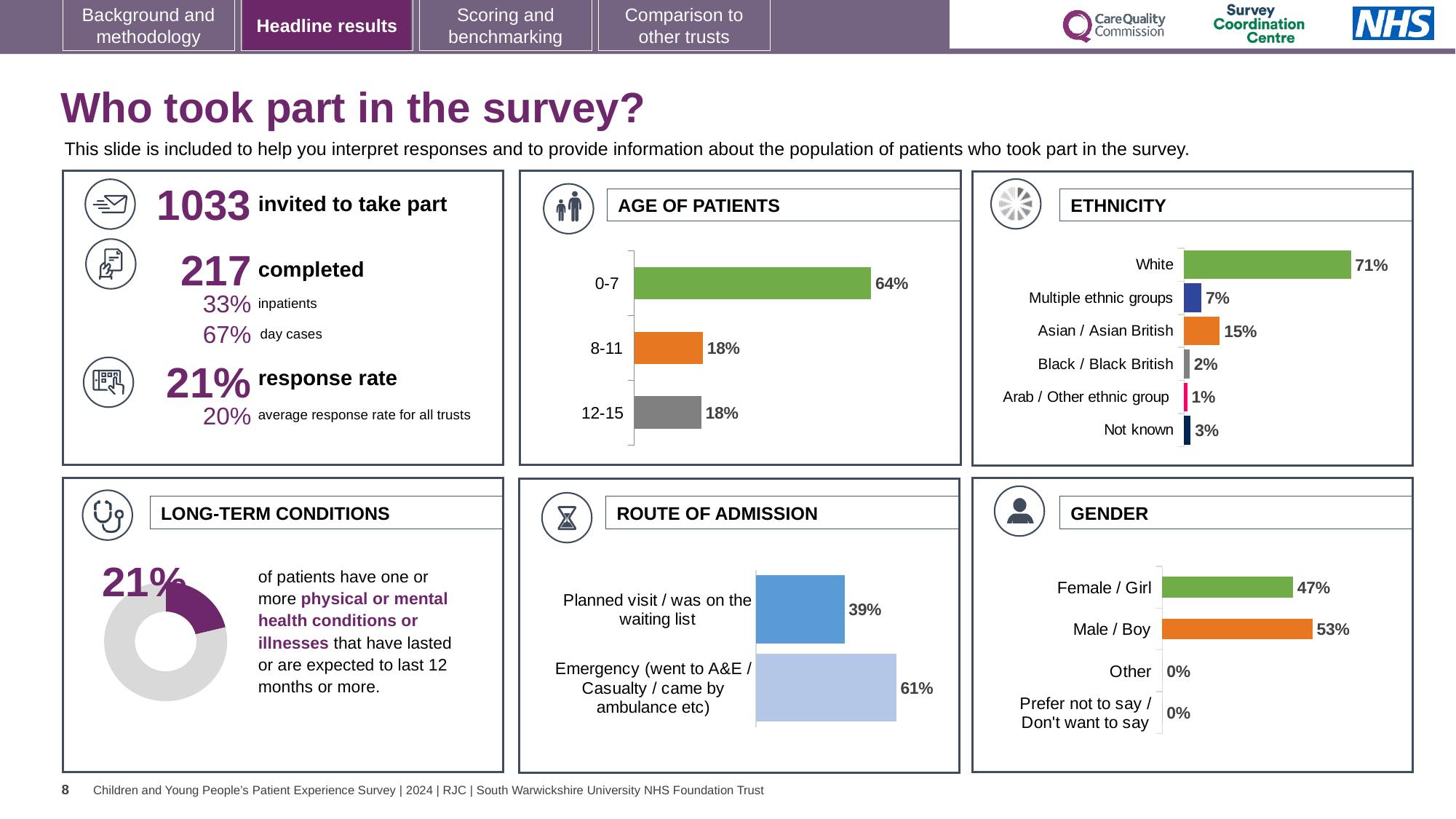
In the ETHNICITY chart, which category has the lowest value? Arab / Other ethnic group In the LONG-TERM CONDITIONS donut chart, what share of patients have one or more long-term conditions? 21% In the GENDER chart, what is the difference between Male / Boy and Female / Girl? 6 percentage points What kind of chart is the ROUTE OF ADMISSION chart? Bar chart In the ROUTE OF ADMISSION chart, what is the value for Emergency (went to A&E / Casualty / came by ambulance etc)? 61% How many categories does the ETHNICITY chart show? 6 In the AGE OF PATIENTS chart, which age group has the highest value? 0-7 In the ETHNICITY chart, which is larger: Multiple ethnic groups or Not known? Multiple ethnic groups In the AGE OF PATIENTS chart, what is the difference between the 0-7 and 8-11 values? 46 percentage points In the GENDER chart, what is the value for Male / Boy? 53% In the AGE OF PATIENTS chart, what is the value for the 0-7 age group? 64% In the ETHNICITY chart, what is the value for Asian / Asian British? 15%